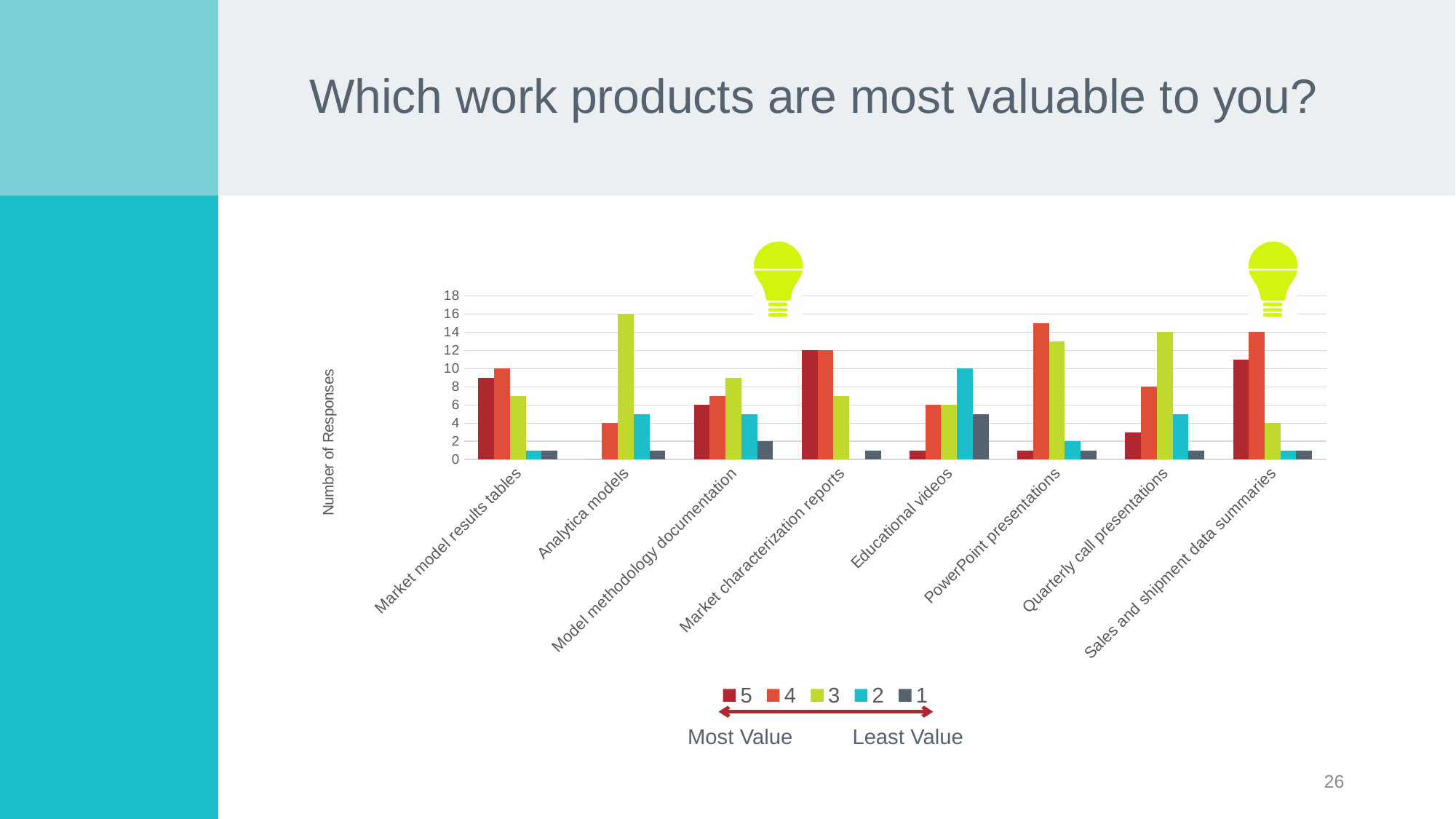
What is the label on the y axis? Number of Responses What kind of chart is shown on the slide? bar chart Is the value for series 5 for Quarterly call presentations greater or less than 4? less Is the value for series 4 for PowerPoint presentations greater or less than 14? greater Which category has the highest series 3 bar? Analytica models What is the number of responses for series 5 for Market characterization reports? 12 How many work product categories are shown on the x axis? 8 Which is larger for Sales and shipment data summaries: series 4 or series 3? series 4 What is the number of responses for series 3 for Quarterly call presentations? 14 What is the number of responses for series 3 for Analytica models? 16 How many series does the legend list? 5 What is the number of responses for series 2 for Educational videos? 10